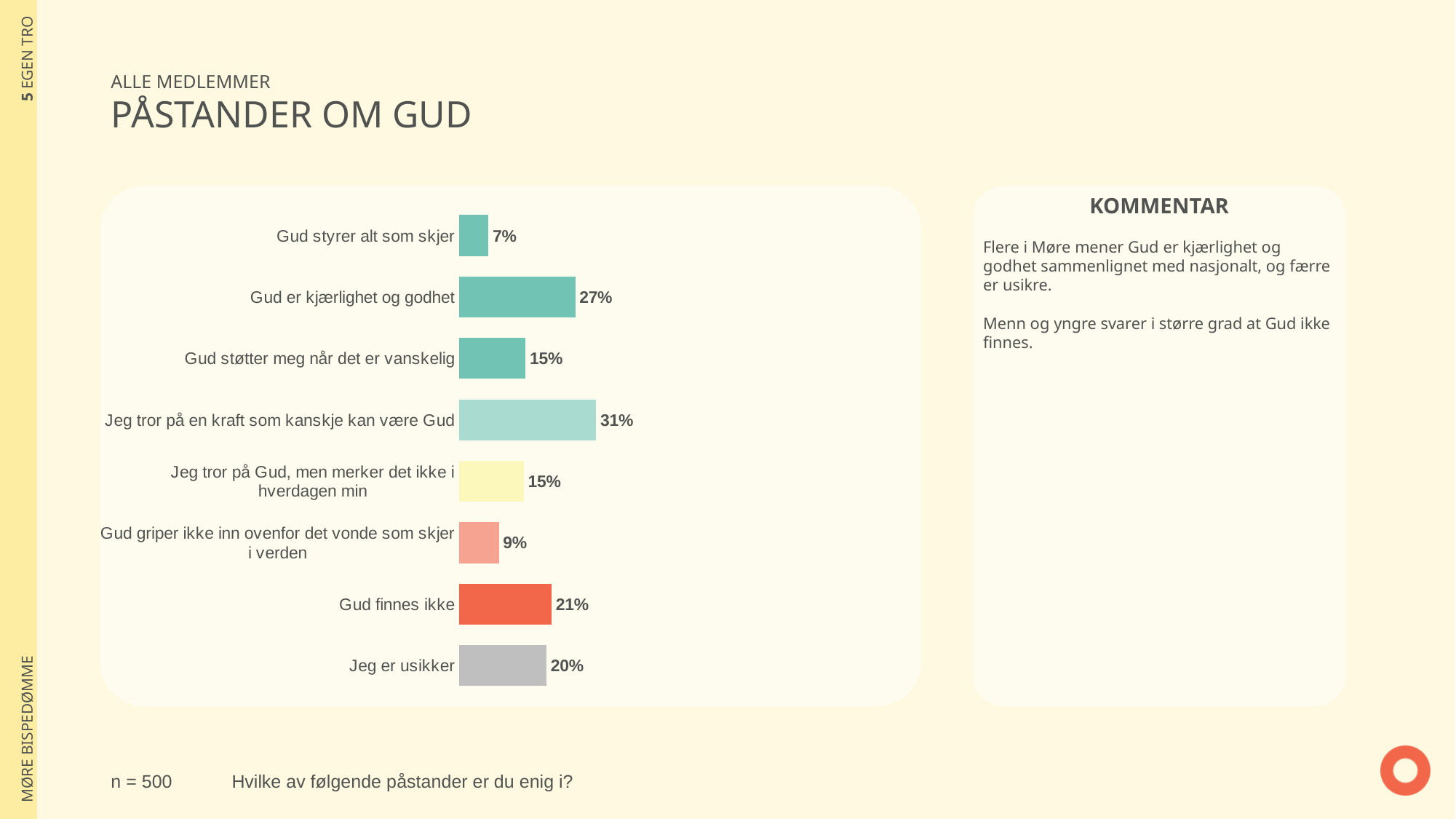
Which statement has the highest percentage? Jeg tror på en kraft som kanskje kan være Gud What percentage is shown for "Jeg er usikker"? 20% Which statement has the lowest percentage? Gud styrer alt som skjer What is the value shown for "Gud finnes ikke"? 21% What is the title of the slide? PÅSTANDER OM GUD What type of chart is shown on the slide? Bar chart What percentage of respondents agree with "Gud styrer alt som skjer"? 7% What is the sample size (n) stated on the slide? n = 500 Which is larger: "Gud støtter meg når det er vanskelig" or "Gud griper ikke inn ovenfor det vonde som skjer i verden"? Gud støtter meg når det er vanskelig What is the difference between "Jeg tror på en kraft som kanskje kan være Gud" and "Jeg er usikker"? 11 percentage points How many statements are shown in the chart? 8 What is the difference between "Gud er kjærlighet og godhet" and "Gud finnes ikke"? 6 percentage points